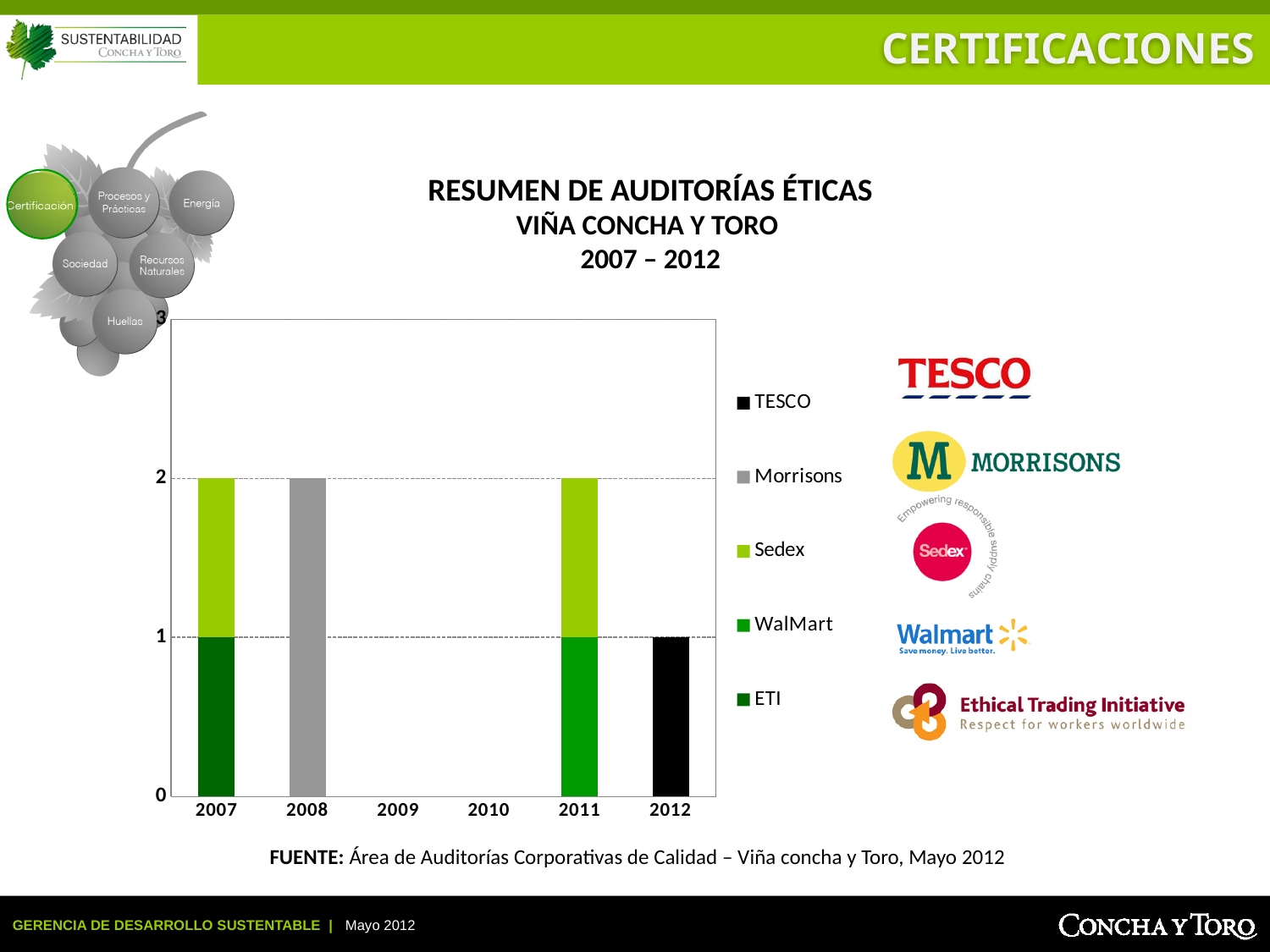
Which series appears in both the 2007 and 2011 bars? Sedex What is the total height of the stacked bar for 2007? 2 Which is larger, the total for 2008 or the total for 2012? 2008 How many years are shown on the x axis of the chart? 6 What kind of chart is shown on the slide? Stacked bar chart What is the difference between the total for 2011 and the total for 2012? 1 What is the value for Morrisons in 2008? 2 How many series does the chart legend list? 5 What period does the chart title say the ethical audits summary covers? 2007 – 2012 What is the total height of the stacked bar for 2011? 2 What is the value for ETI in 2007? 1 What is the value for TESCO in 2012? 1